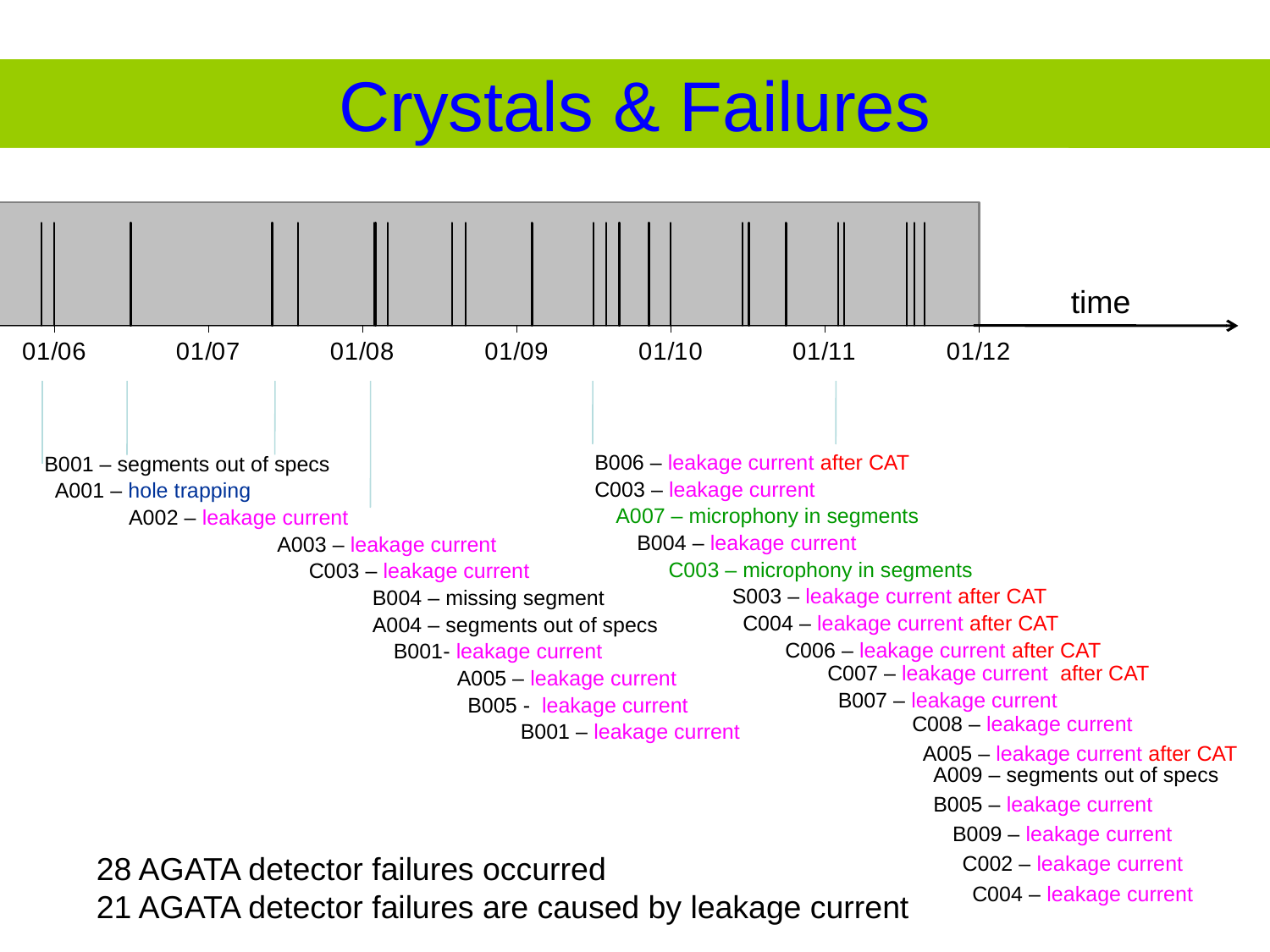
What is the title of the slide's timeline chart? Crystals & Failures How many of the 28 AGATA detector failures were not caused by leakage current? 7 Which failure cause appears most often in the list of failures on the timeline? leakage current What is the last date label on the timeline axis? 01/12 What is the earliest failure listed on the timeline? B001 – segments out of specs How many date labels are shown along the timeline axis? 7 What kind of chart is shown on the slide? Timeline According to the slide, how many AGATA detector failures occurred? 28 According to the slide, how many AGATA detector failures are caused by leakage current? 21 What failure is listed for crystal A001 on the timeline? hole trapping What is the first date label on the timeline axis? 01/06 What is the label on the horizontal axis of the timeline? time